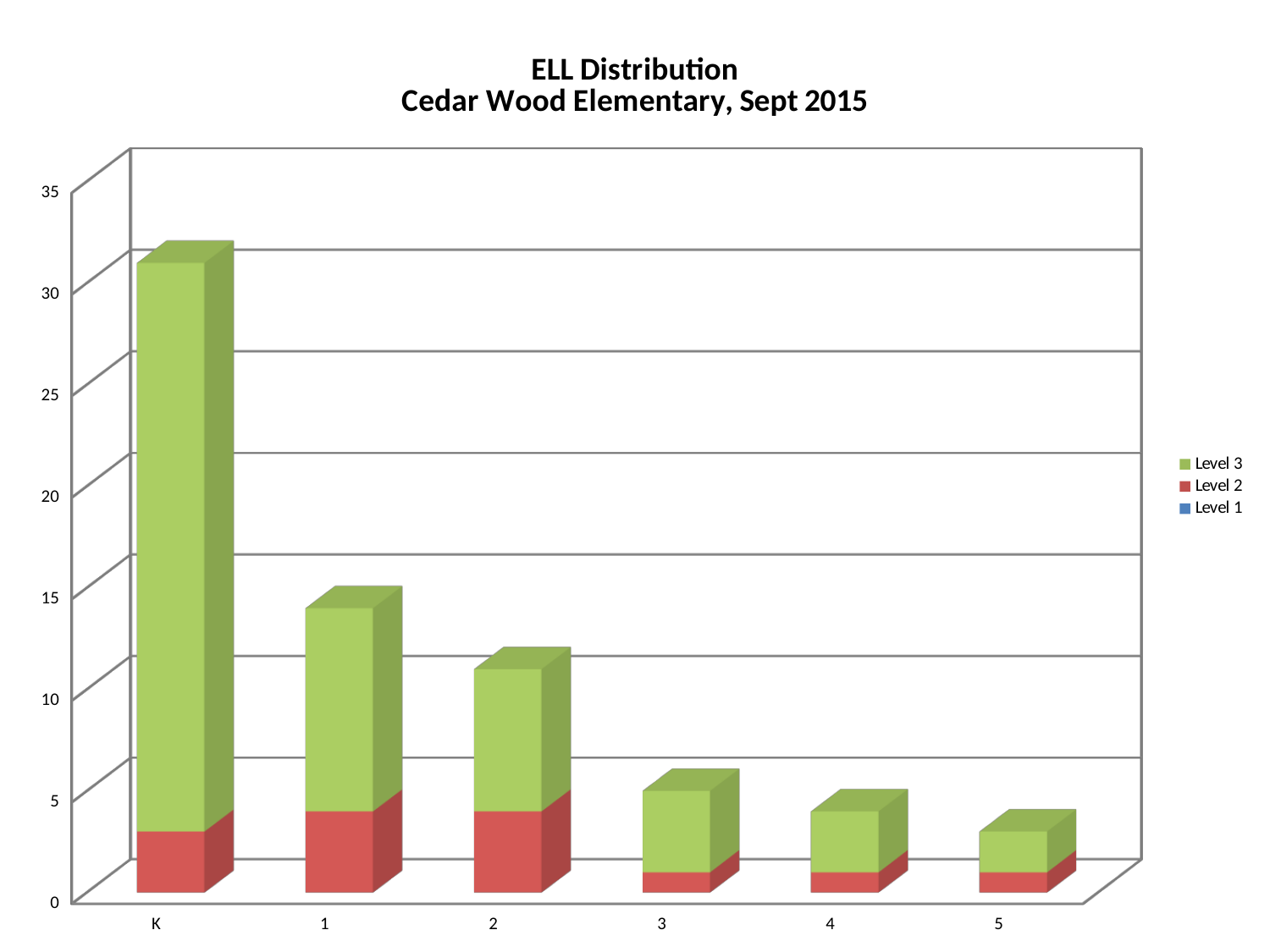
How many series does the legend list? 3 What kind of chart is shown on the slide? bar chart Do the bar totals generally rise or fall from K to grade 5? fall What is the title of the chart? ELL Distribution Cedar Wood Elementary, Sept 2015 Which bar is taller, K or grade 1? K Which grade level has the tallest bar? K Is the total bar for grade 1 greater or less than 10? greater How many grade-level categories are shown on the x axis? 6 Is the total bar for grade 3 greater or less than 10? less Is the total bar for K greater or less than 25? greater Which grade level has the shortest bar? 5